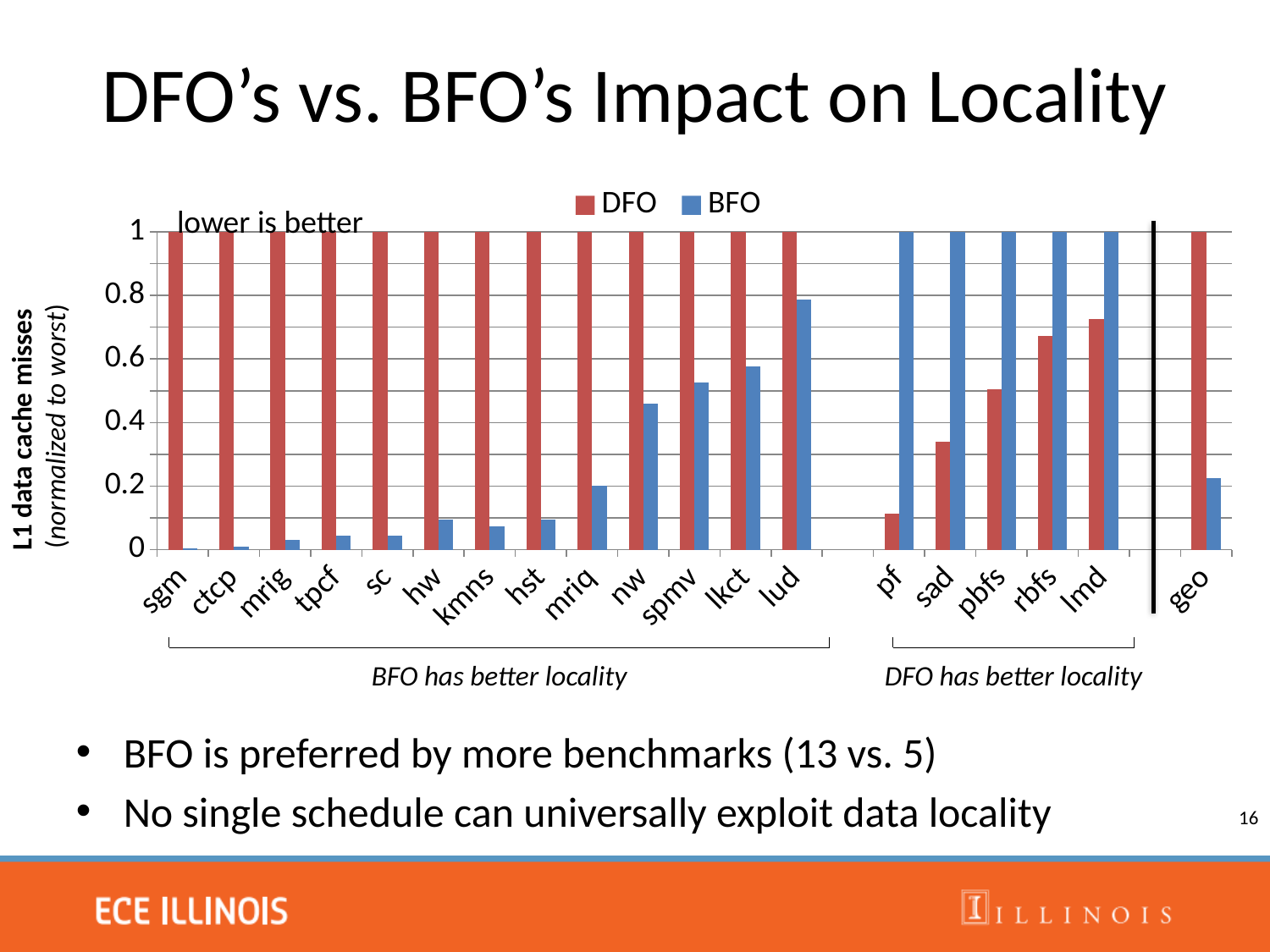
Is the DFO value for sad greater or less than 0.4? less What is the BFO value for pf? 1 Is the DFO value for lmd greater or less than 0.6? greater What are the two series named in the chart legend? DFO and BFO What kind of chart is shown on the slide? bar chart For the benchmark lud, which series has the larger value, DFO or BFO? DFO What is the DFO value for sgm? 1 How many benchmark categories are plotted along the x axis of the chart? 19 How many series does the chart legend list? 2 Is the BFO value for mriq greater or less than 0.4? less For the benchmark rbfs, which series has the larger value, DFO or BFO? BFO